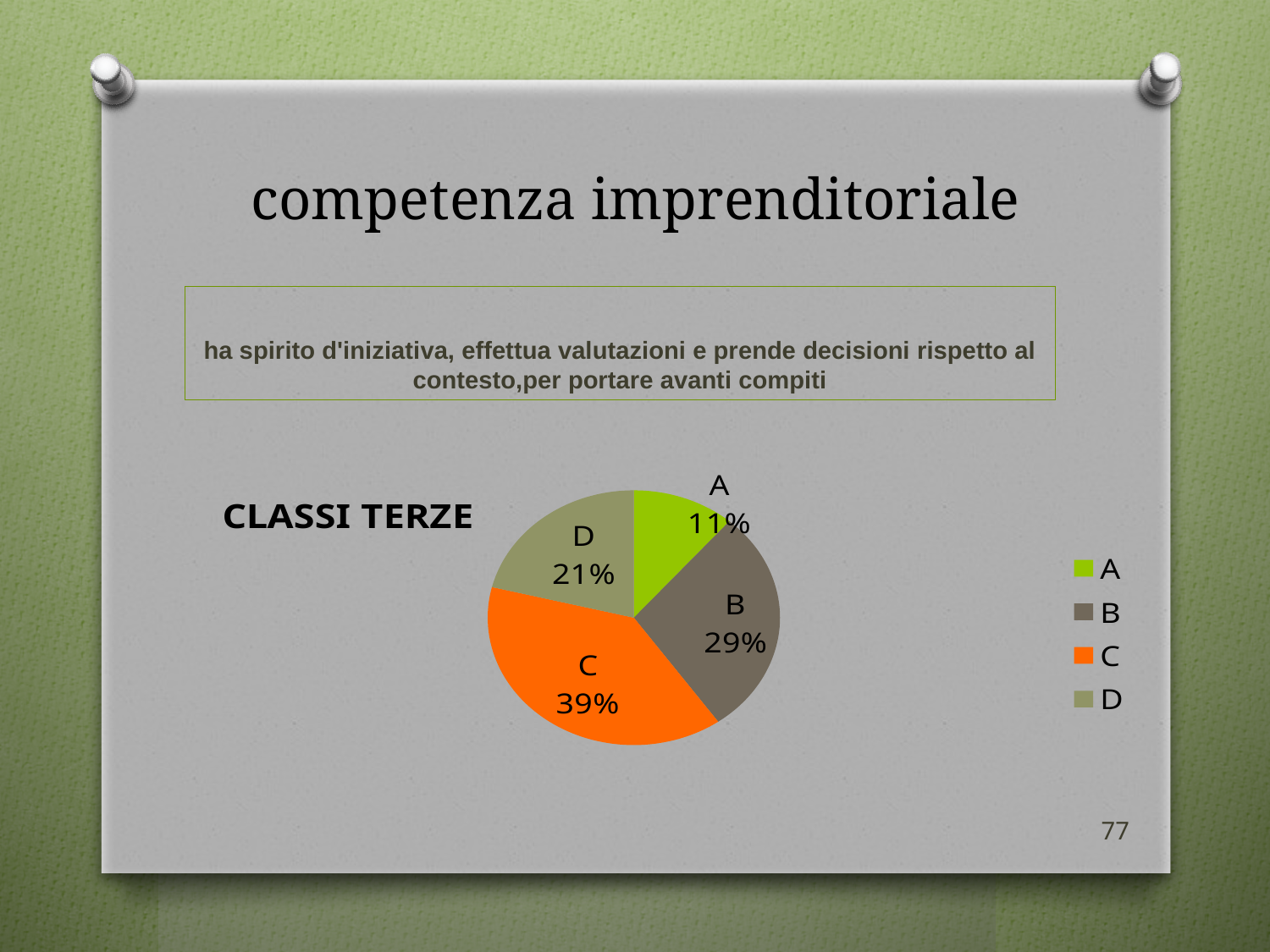
What is the difference in percentage points between category C and category B? 10 What is the share for category C in the pie chart? 39% How many categories does the pie chart have? 4 What is the share for category B in the pie chart? 29% What label appears to the left of the pie chart? CLASSI TERZE Which is larger, the share for B or the share for D? B Which category has the smallest slice of the pie chart? A What is the share for category A in the pie chart? 11% How many entries does the legend list? 4 What is the share for category D in the pie chart? 21% What type of chart is shown on the slide? pie chart Which category has the largest slice of the pie chart? C